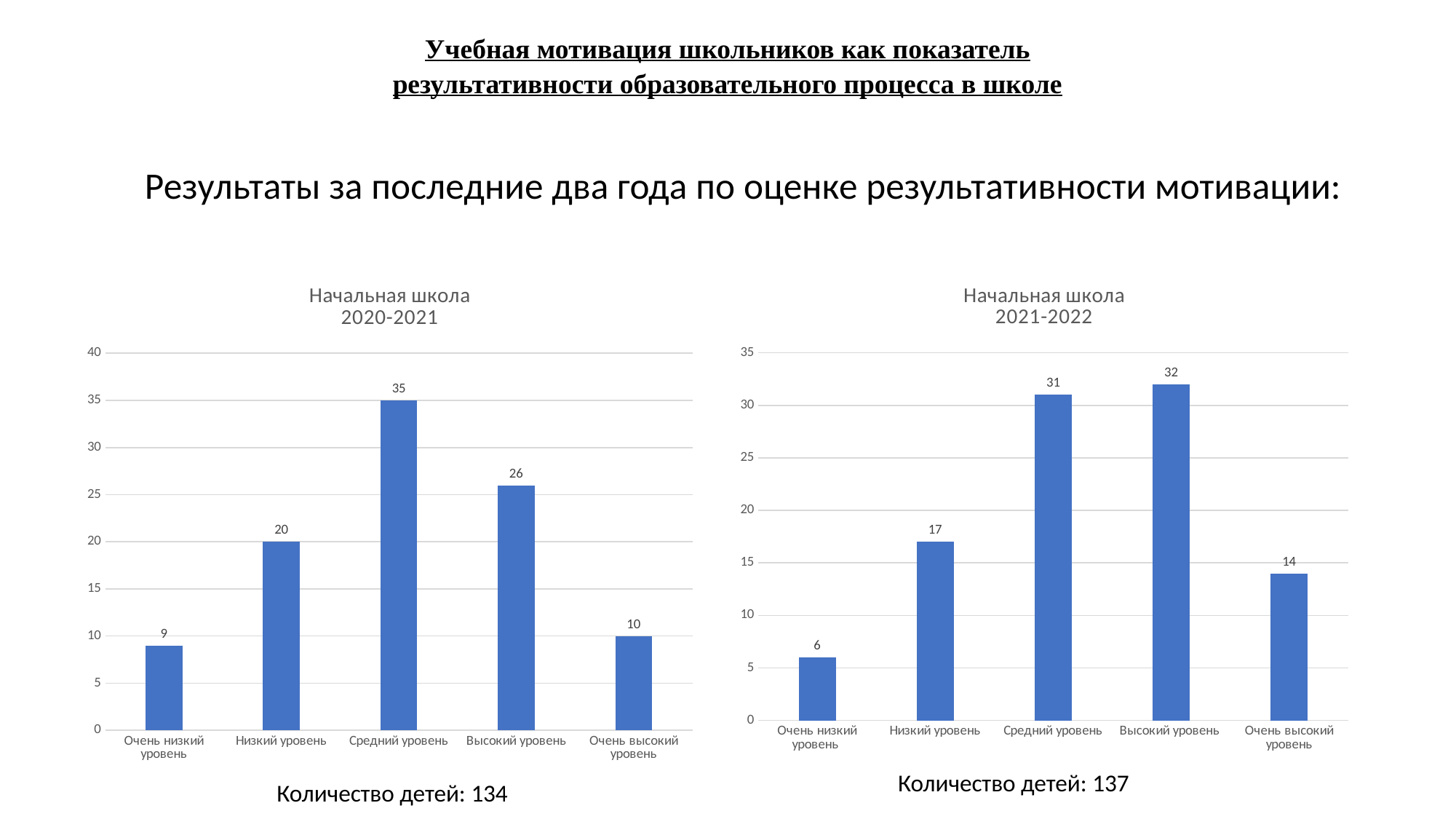
In the 'Начальная школа 2020-2021' chart, which category has the highest value? Средний уровень How many categories are shown in the 'Начальная школа 2021-2022' chart? 5 In the 'Начальная школа 2020-2021' chart, what is the value for Очень низкий уровень? 9 In the 'Начальная школа 2021-2022' chart, which is larger: Средний уровень or Высокий уровень? Высокий уровень In the 'Начальная школа 2021-2022' chart, what is the value for Очень высокий уровень? 14 In the 'Начальная школа 2021-2022' chart, what is the difference between Высокий уровень and Низкий уровень? 15 In the 'Начальная школа 2020-2021' chart, is the value for Низкий уровень greater or less than 15? greater In the 'Начальная школа 2020-2021' chart, what is the value for Средний уровень? 35 In the 'Начальная школа 2020-2021' chart, what is the difference between Средний уровень and Высокий уровень? 9 What is the title of the chart on the right side of the slide? Начальная школа 2021-2022 In the 'Начальная школа 2021-2022' chart, which category has the lowest value? Очень низкий уровень What type of chart is the 'Начальная школа 2020-2021' chart? bar chart